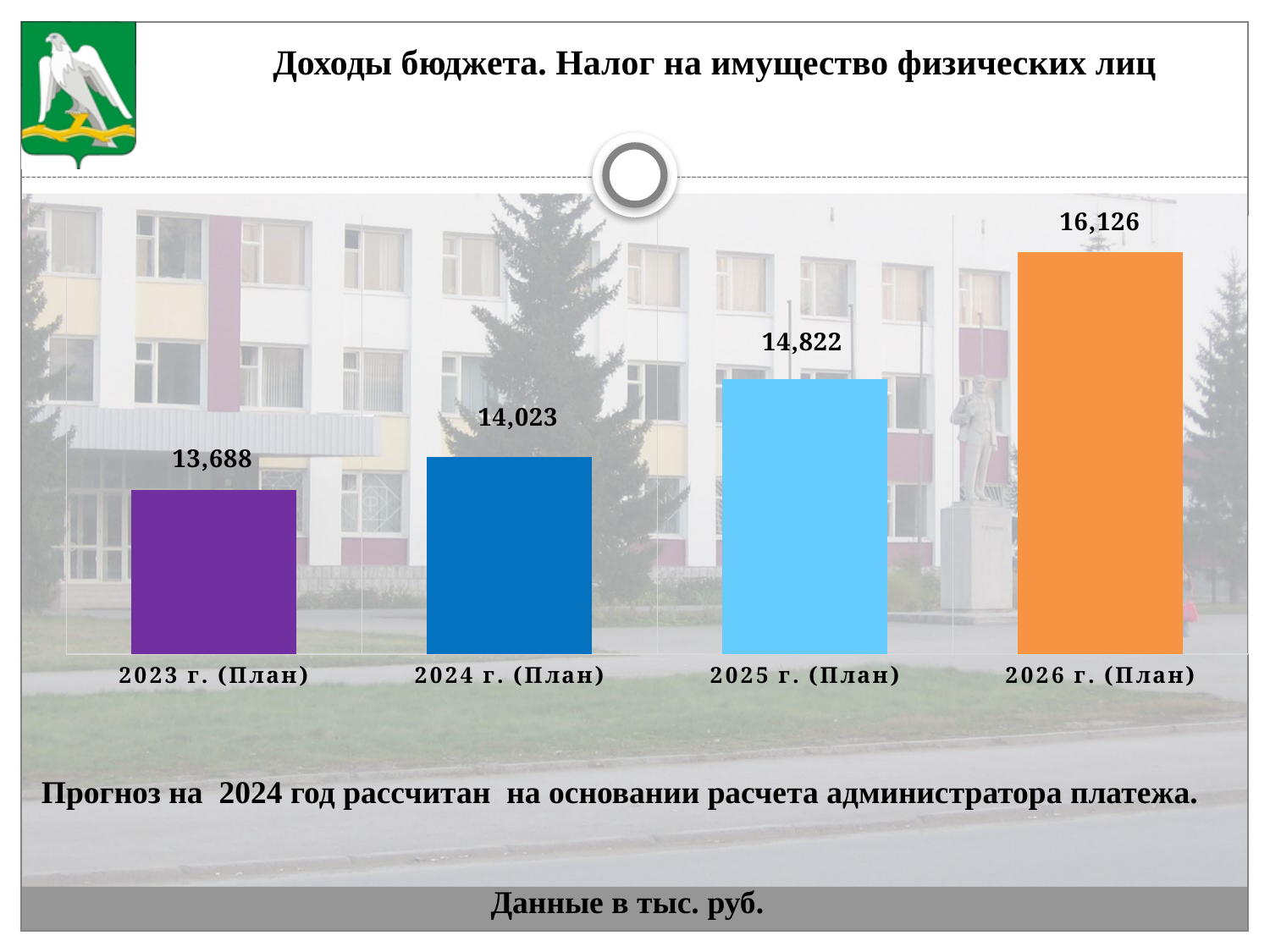
What kind of chart is shown on the slide? Bar chart What is the value for 2023 г. (План)? 13,688 What is the value for 2026 г. (План)? 16,126 How many bars are shown in the chart? 4 Which is larger, the value for 2025 г. (План) or 2024 г. (План)? 2025 г. (План) Do the values rise or fall from 2023 to 2026? Rise Which year has the lowest value? 2023 г. (План) What is the value for 2025 г. (План)? 14,822 What is the difference between the values for 2024 г. (План) and 2023 г. (План)? 335 What is the difference between the values for 2026 г. (План) and 2025 г. (План)? 1,304 In what units are the chart data given, according to the slide? тыс. руб. Which year has the highest value? 2026 г. (План)